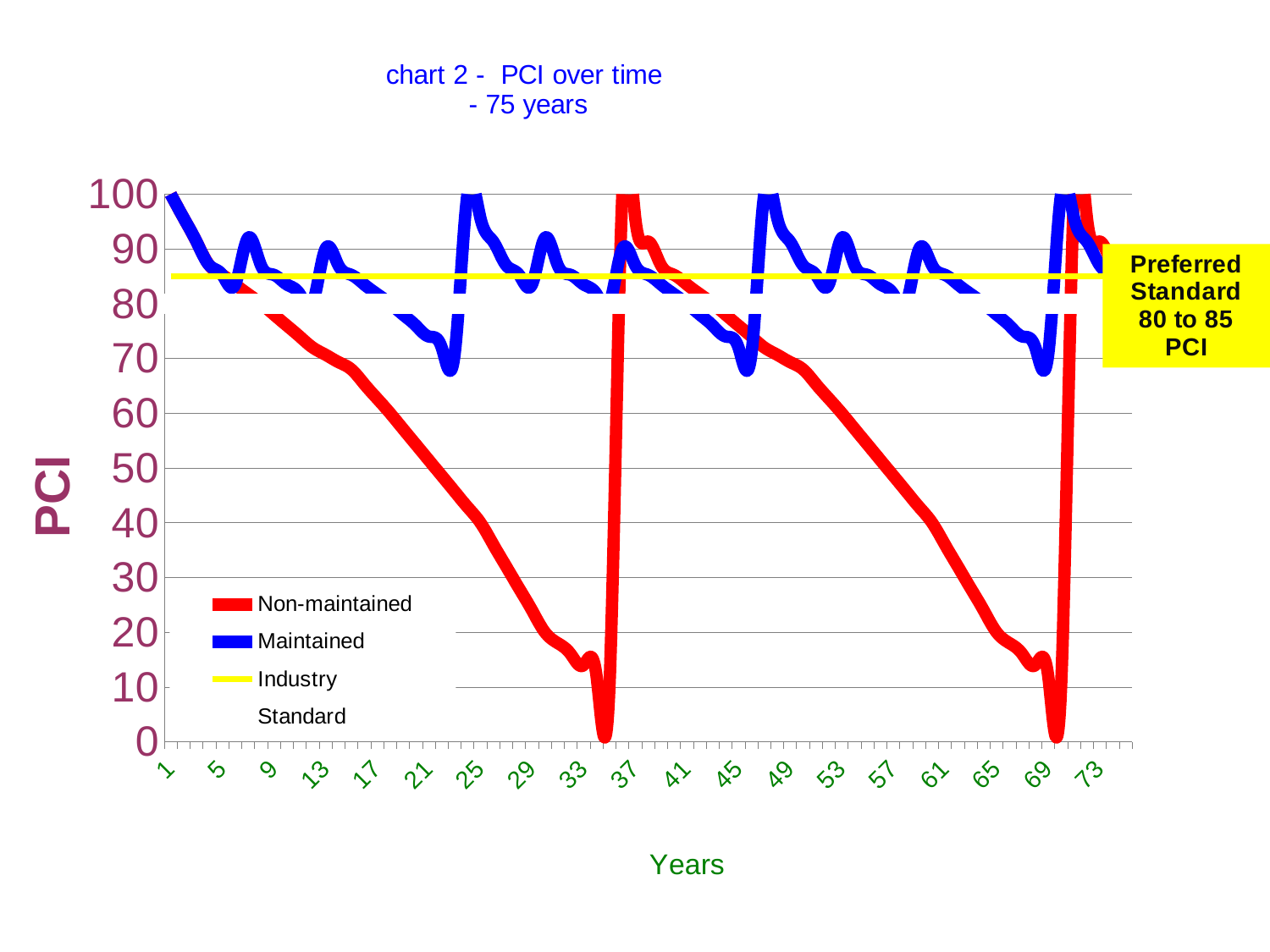
Is the Maintained value at year 23 greater or less than 80? less What kind of chart is shown on the slide? line chart What is the title of the chart? chart 2 - PCI over time - 75 years At year 29, which series has the higher value, Maintained or Non-maintained? Maintained Does the Non-maintained series rise or fall from year 5 to year 33? fall Is the Industry Standard line greater or less than 80? greater Is the Non-maintained value at year 33 greater or less than 20? less What is the label on the x axis? Years What is the Maintained value at year 1? 100